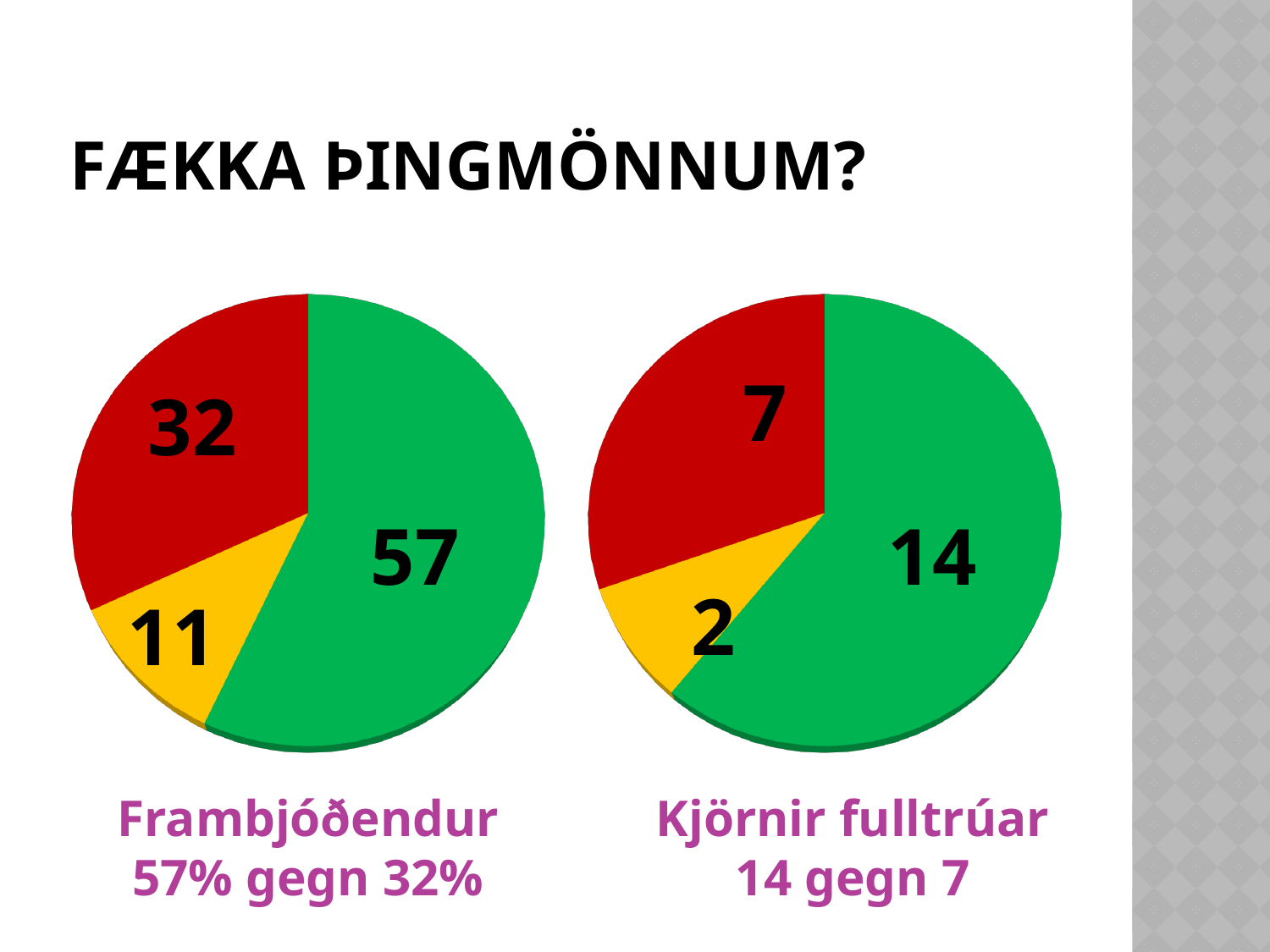
What is the title of the slide containing the two pie charts? FÆKKA ÞINGMÖNNUM? In the right pie chart (Kjörnir fulltrúar), what value is shown on the red slice? 7 In the left pie chart (Frambjóðendur), what value is shown on the green slice? 57 In the right pie chart (Kjörnir fulltrúar), which is larger, the red slice or the yellow slice? red In the left pie chart (Frambjóðendur), what is the difference between the green slice and the red slice? 25 In the right pie chart (Kjörnir fulltrúar), what is the difference between the green slice and the red slice? 7 What kind of chart is shown on the left of the slide, labelled Frambjóðendur? pie chart In the right pie chart (Kjörnir fulltrúar), what value is shown on the green slice? 14 In the right pie chart (Kjörnir fulltrúar), which slice has the smallest value? yellow (2) In the left pie chart (Frambjóðendur), what value is shown on the yellow slice? 11 In the left pie chart (Frambjóðendur), which slice has the largest value? green (57) How many slices does the left pie chart (Frambjóðendur) have? 3